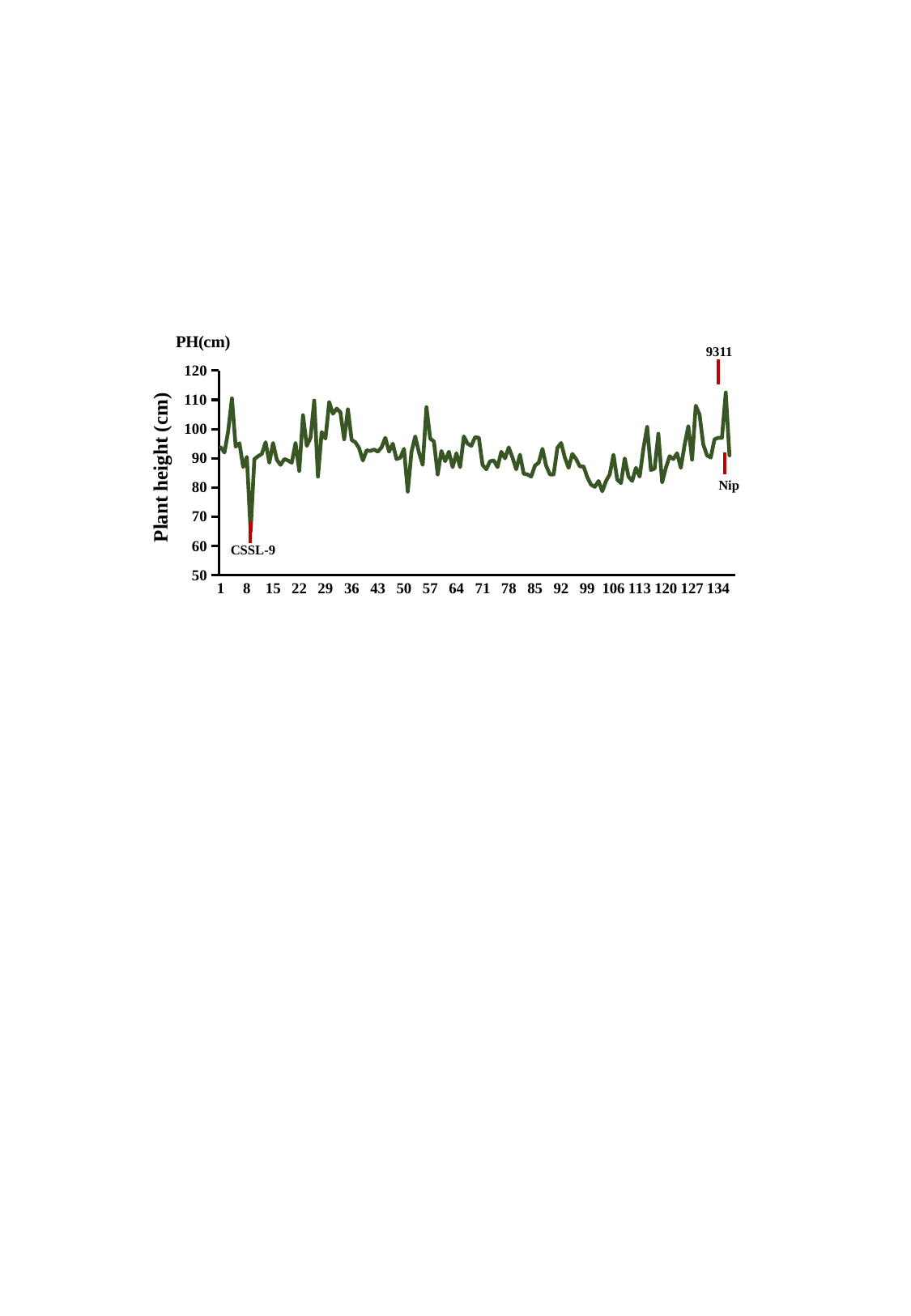
Which of the three labelled lines (CSSL-9, 9311, Nip) has the highest plant height? 9311 Which has the greater plant height, CSSL-9 or Nip? Nip Is the plant height for Nip greater or less than 100? less How many tick labels are shown along the horizontal axis of the chart? 20 Is the plant height for 9311 greater or less than 100? greater Is the plant height for CSSL-9 greater or less than 70? less What is the highest value shown on the vertical axis of the chart? 120 Which of the three labelled lines (CSSL-9, 9311, Nip) has the lowest plant height? CSSL-9 What kind of chart is shown on the slide? line chart Which has the greater plant height, 9311 or Nip? 9311 What is the label on the vertical axis of the chart? Plant height (cm)